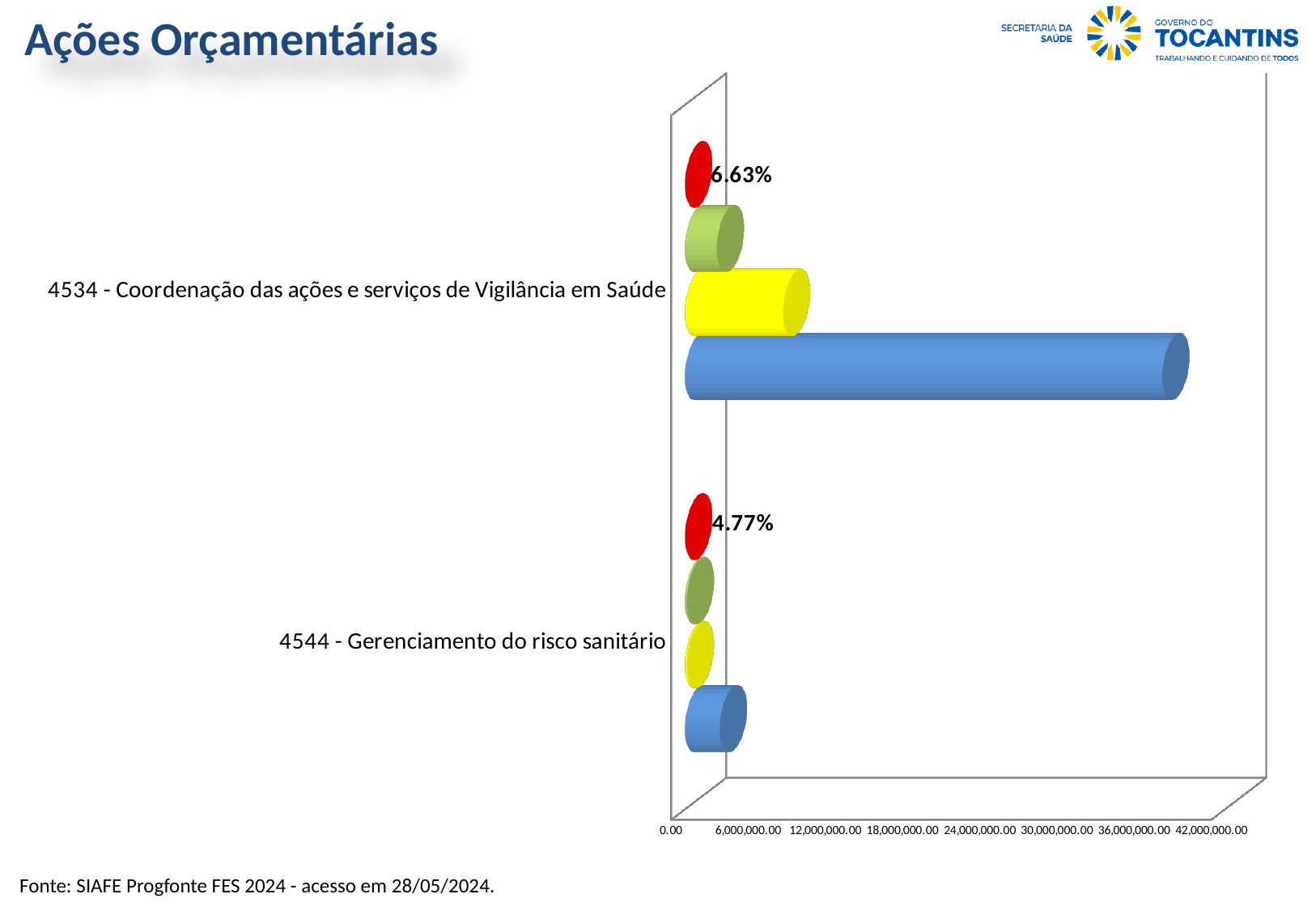
What percentage is labelled for the category "4544 - Gerenciamento do risco sanitário"? 4.77% How many categories are shown on the chart? 2 What is the highest value shown on the horizontal axis of the chart? 42,000,000.00 Which category has the longest bar on the chart? 4534 - Coordenação das ações e serviços de Vigilância em Saúde Is the value of the blue bar for category 4534 greater or less than 36,000,000.00? greater What kind of chart is shown on the slide? Bar chart What percentage is labelled for the category "4534 - Coordenação das ações e serviços de Vigilância em Saúde"? 6.63% Is the value of the yellow bar for category 4534 greater or less than 6,000,000.00? greater Is the value of the blue bar for category 4544 greater or less than 6,000,000.00? less Which category has the higher percentage label, 4534 or 4544? 4534 - Coordenação das ações e serviços de Vigilância em Saúde What is the title of the slide containing the chart? Ações Orçamentárias What is the difference between the percentage labels of category 4534 and category 4544? 1.86 percentage points